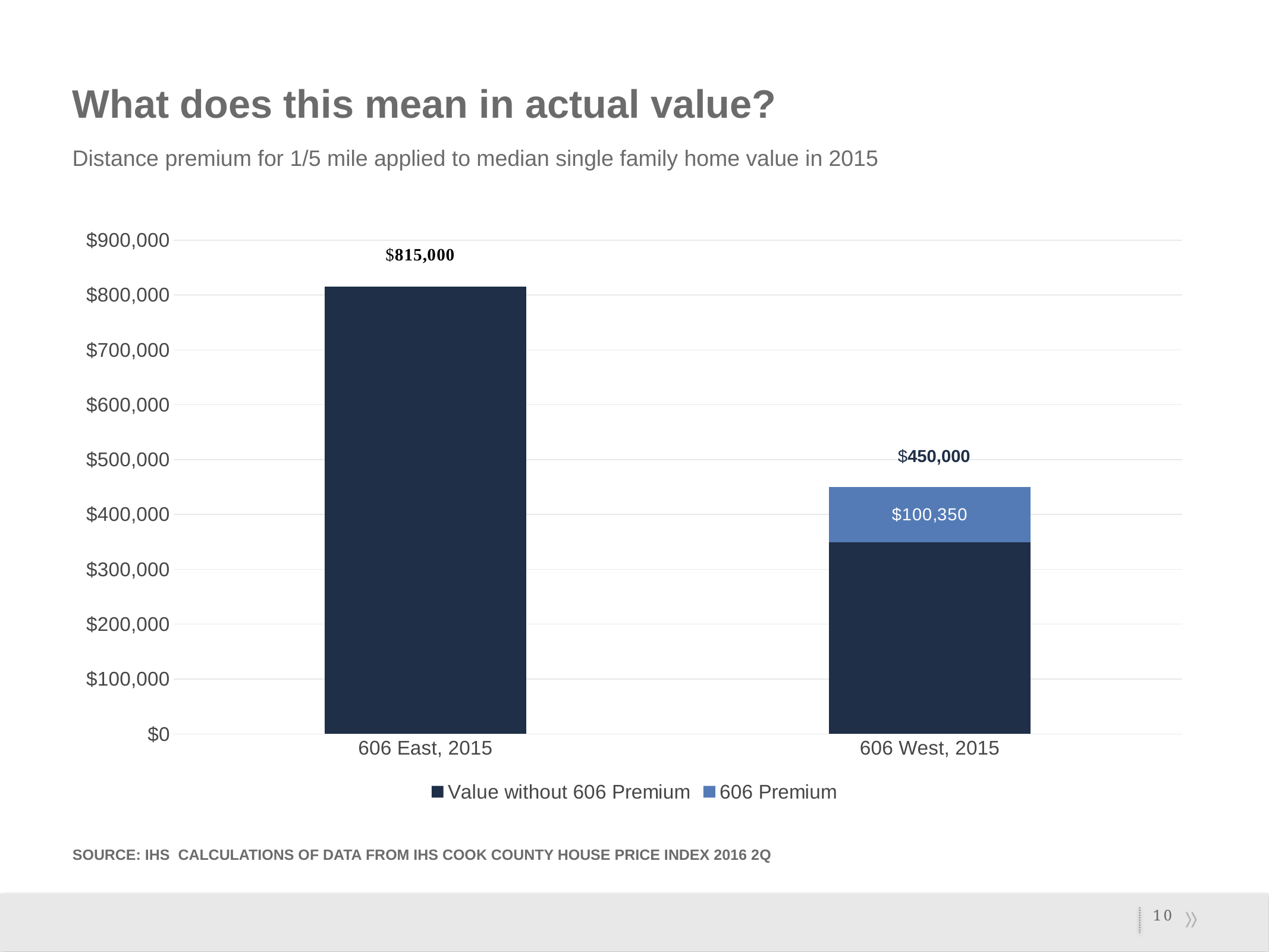
Is the Value without 606 Premium for 606 West, 2015 greater or less than $400,000? less What is the difference between the total for 606 East, 2015 and the total for 606 West, 2015? $365,000 How many categories are shown on the x axis of the chart? 2 What are the two series named in the chart's legend? Value without 606 Premium and 606 Premium What is the difference between the total for 606 West, 2015 and its 606 Premium segment? $349,650 Which category has the higher total value? 606 East, 2015 Is the total for 606 East, 2015 larger or smaller than the total for 606 West, 2015? larger What is the value of the 606 Premium segment for 606 West, 2015? $100,350 What is the total value labelled for 606 East, 2015? $815,000 What kind of chart is shown on the slide? bar chart What is the total value labelled for 606 West, 2015? $450,000 How many series does the chart's legend list? 2